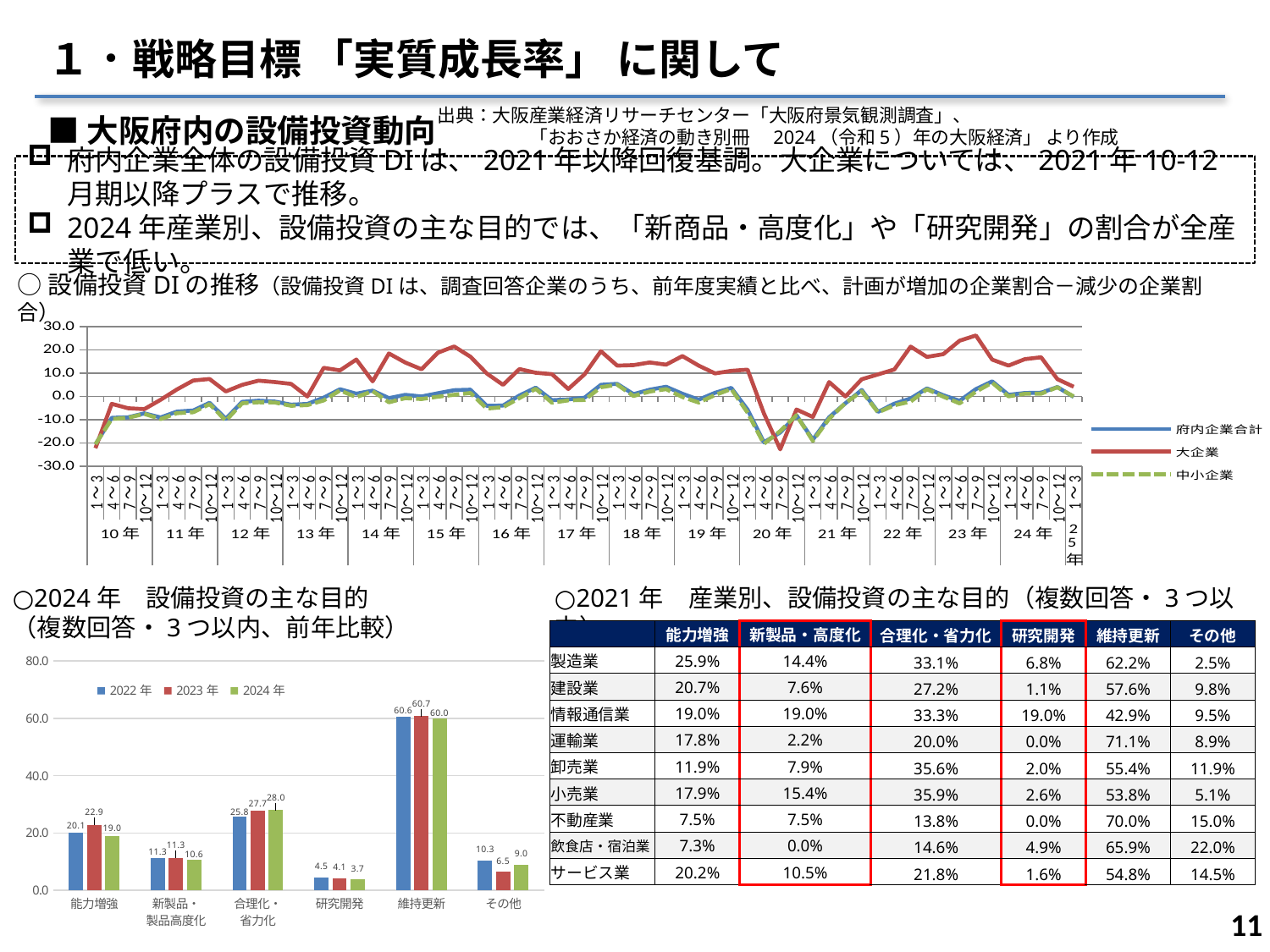
In the line chart titled 設備投資DIの推移, how many series does the legend list? 3 In the bar chart titled 2024年 設備投資の主な目的, what is the value for 能力増強 in 2023年? 22.9 In the bar chart titled 2024年 設備投資の主な目的, how many categories are shown on the x axis? 6 In the bar chart titled 2024年 設備投資の主な目的, what is the value for 維持更新 in 2024年? 60.0 In the bar chart titled 2024年 設備投資の主な目的, which is larger for その他: the 2022年 value or the 2023年 value? 2022年 What kind of chart is the chart titled 設備投資DIの推移 at the top of the slide? line chart In the bar chart titled 2024年 設備投資の主な目的, how many series does the legend list? 3 In the bar chart titled 2024年 設備投資の主な目的, what is the difference between the 2024年 values for 合理化・省力化 and 能力増強? 9.0 In the line chart titled 設備投資DIの推移, is the highest value of the 大企業 series greater or less than 20.0? greater In the bar chart titled 2024年 設備投資の主な目的, which category has the lowest value in 2022年? 研究開発 In the bar chart titled 2024年 設備投資の主な目的, which category has the highest value in 2024年? 維持更新 In the bar chart titled 2024年 設備投資の主な目的, what is the value for 研究開発 in 2024年? 3.7